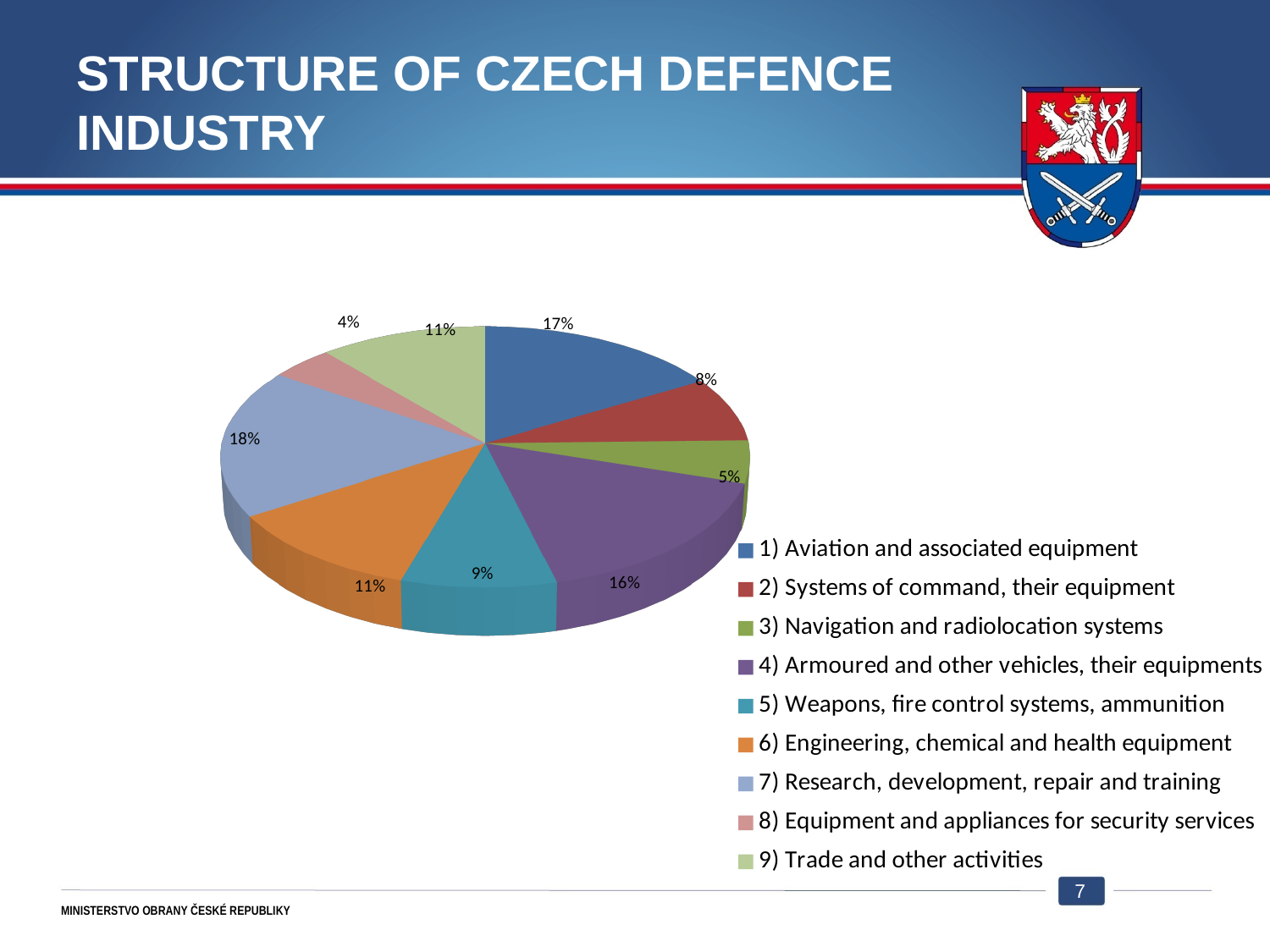
What share is shown for Armoured and other vehicles, their equipments? 16% How many categories does the pie chart show? 9 What percentage does the slice for Research, development, repair and training represent? 18% How many percentage points larger is the Aviation and associated equipment share than the Systems of command, their equipment share? 9 What is the combined share of Engineering, chemical and health equipment and Trade and other activities? 22% What share of the Czech defence industry is Aviation and associated equipment? 17% Which category has the smallest share of the pie? 8) Equipment and appliances for security services Which category has the largest share of the pie? 7) Research, development, repair and training What is the title of the slide containing the chart? STRUCTURE OF CZECH DEFENCE INDUSTRY Which is larger: the share for Weapons, fire control systems, ammunition or the share for Systems of command, their equipment? Weapons, fire control systems, ammunition What percentage is labelled for Navigation and radiolocation systems? 5% What type of chart is shown on the slide? Pie chart